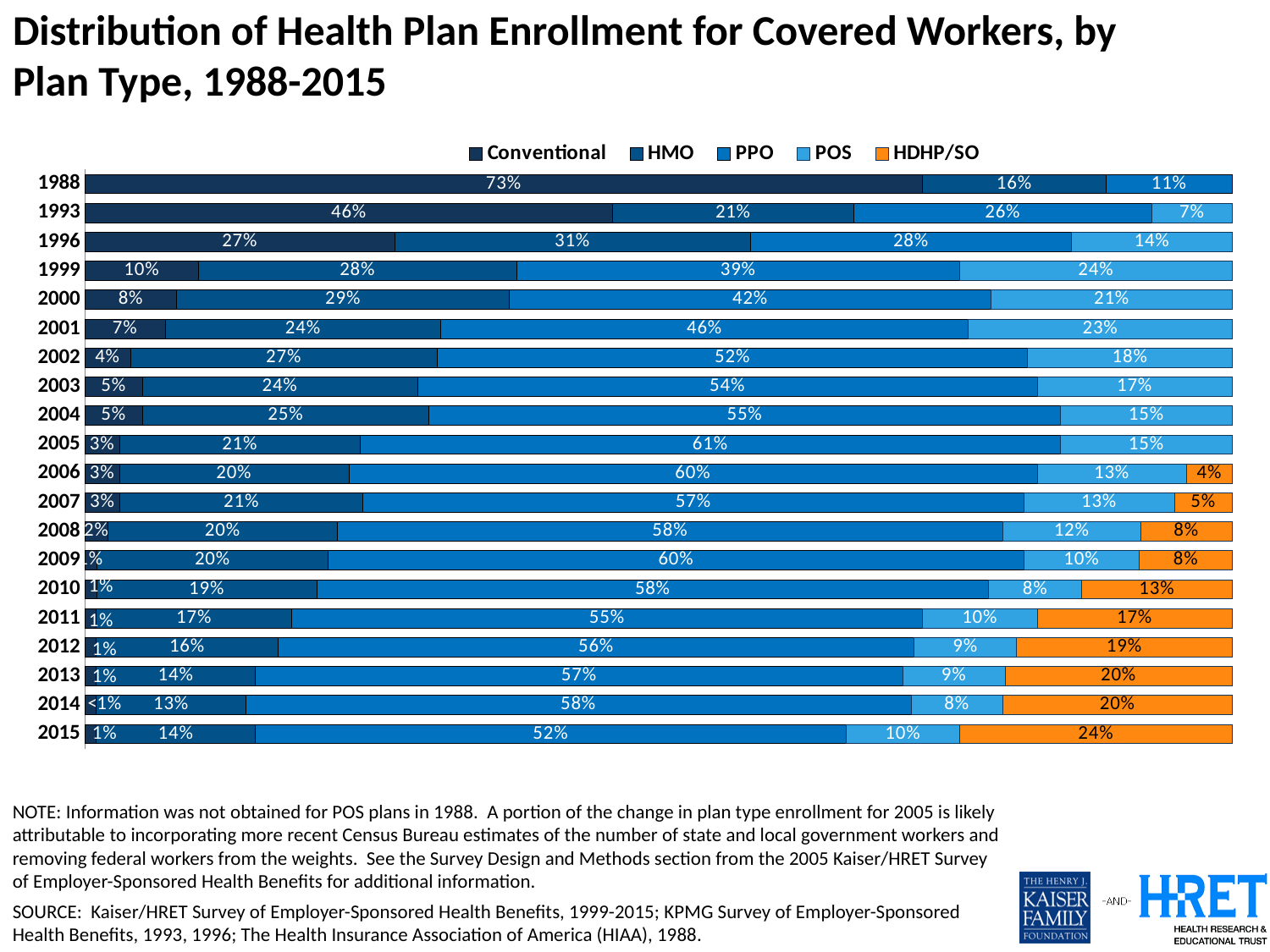
What kind of chart is shown on the slide? Stacked bar chart Which was larger in 2011: the HMO share or the HDHP/SO share? They are equal (17%) What was the HMO enrollment share in 2000? 29% What share of covered workers were in HDHP/SO plans in 2015? 24% In which year was the PPO share the highest? 2005 What is the difference between the PPO share in 2014 and the PPO share in 2015? 6% How many years are shown on the chart? 20 How many plan types does the legend list? 5 Does the HDHP/SO share rise or fall from 2006 to 2015? Rise What was the PPO enrollment share in 2005? 61% In which year was the Conventional plan share the highest? 1988 What percentage of covered workers were enrolled in Conventional plans in 1988? 73%